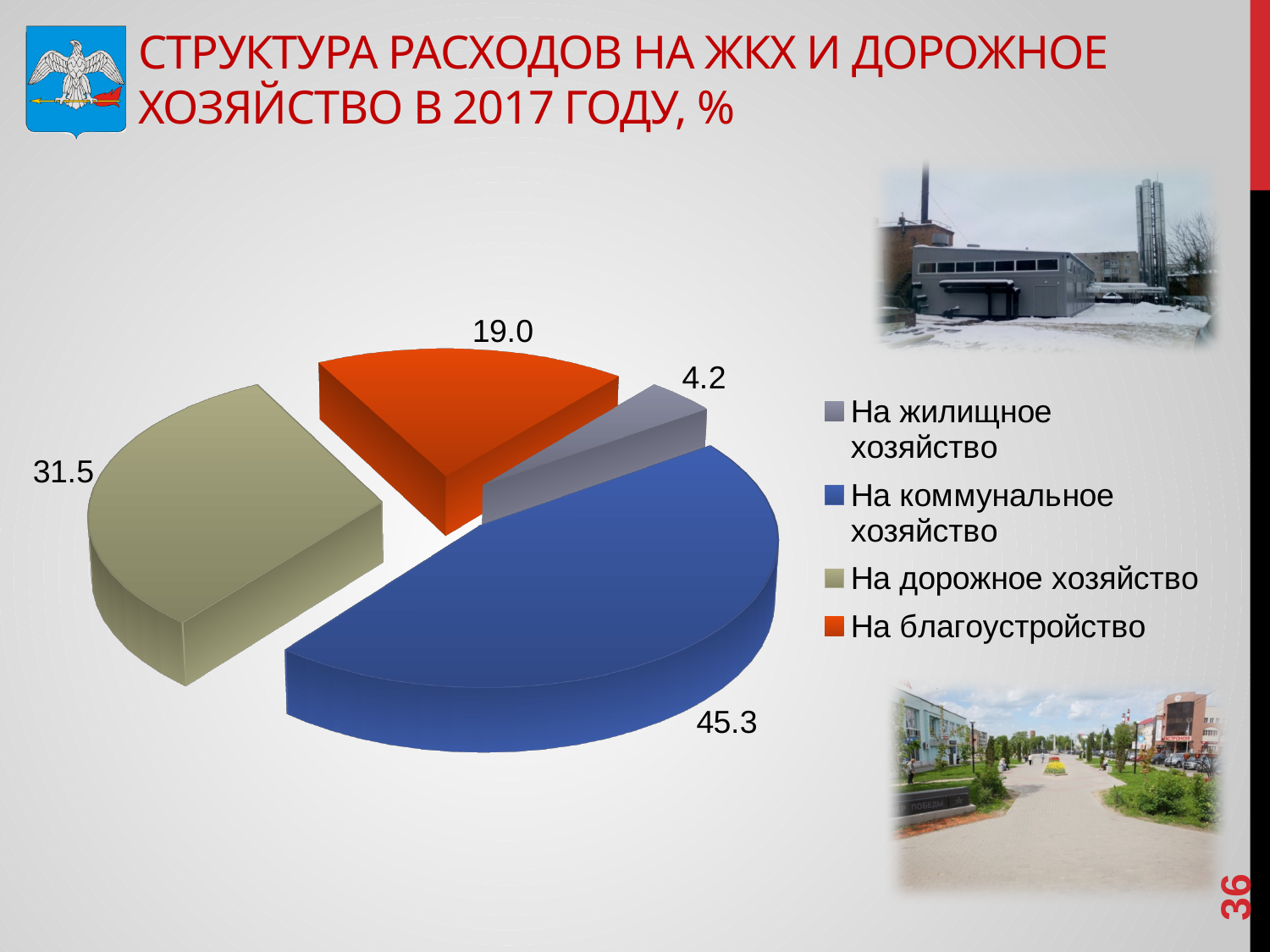
What is the value for "На дорожное хозяйство"? 31.5 What is the title of the slide containing the chart? Структура расходов на ЖКХ и дорожное хозяйство в 2017 году, % Which category has the smallest share of the pie? На жилищное хозяйство What is the value for "На жилищное хозяйство"? 4.2 What is the value for "На коммунальное хозяйство"? 45.3 What kind of chart is shown on the slide? Pie chart What is the difference between the values for "На коммунальное хозяйство" and "На дорожное хозяйство"? 13.8 How many categories does the pie chart have? 4 Which category has the largest share of the pie? На коммунальное хозяйство What is the value for "На благоустройство"? 19.0 Which is larger: the value for "На благоустройство" or the value for "На жилищное хозяйство"? На благоустройство What colour is the slice for "На благоустройство"? Orange-red